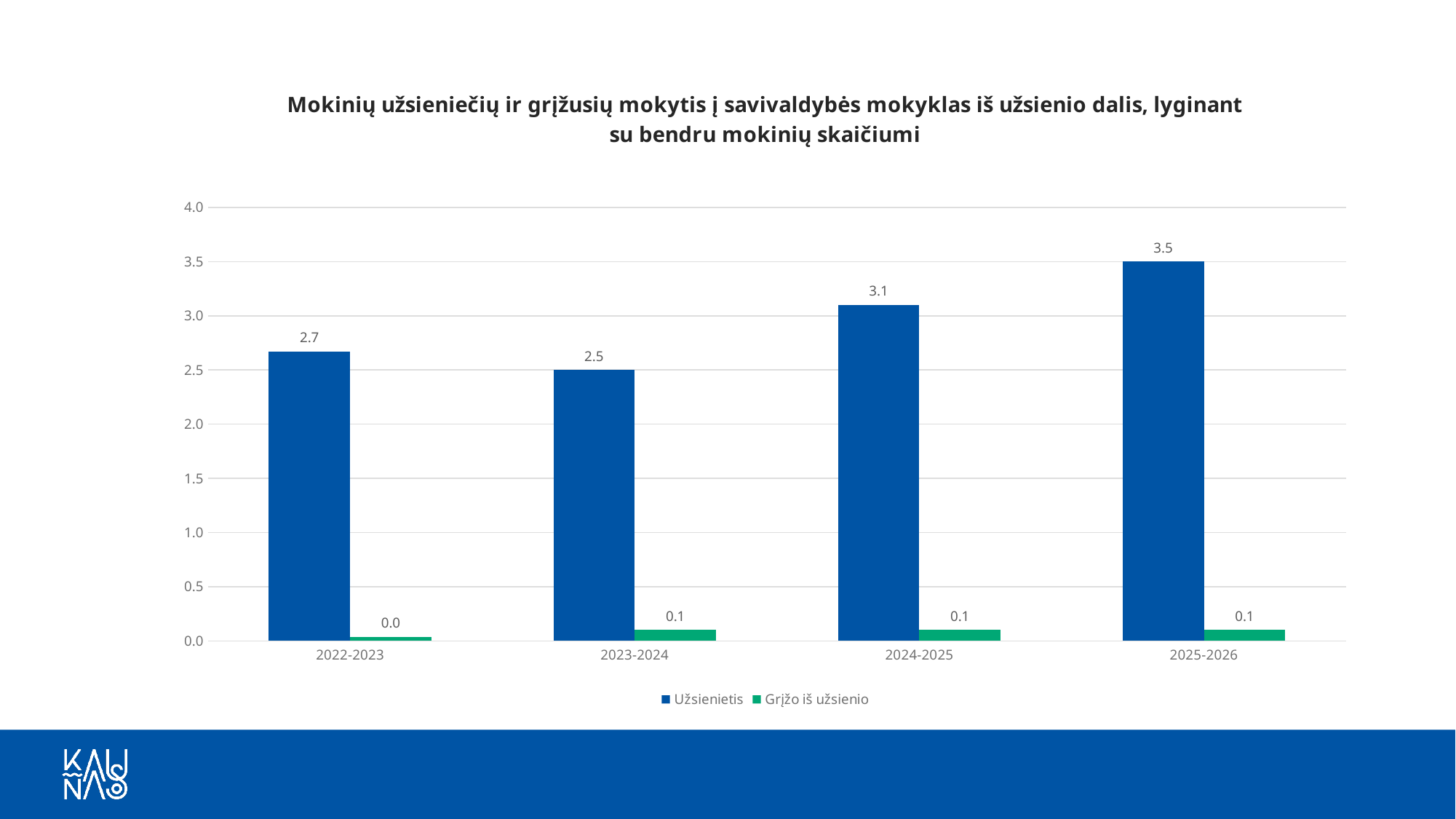
What kind of chart is shown on the slide? Bar chart How many series does the legend list? 2 What is the value for Užsienietis in 2025-2026? 3.5 Which is larger, the Užsienietis value for 2022-2023 or for 2024-2025? 2024-2025 What is the difference between the Užsienietis values for 2025-2026 and 2022-2023? 0.8 In which school year is the Užsienietis value lowest? 2023-2024 In which school year is the Grįžo iš užsienio value lowest? 2022-2023 What is the value for Grįžo iš užsienio in 2024-2025? 0.1 What is the value for Grįžo iš užsienio in 2022-2023? 0.0 What is the value for Užsienietis in 2023-2024? 2.5 How many school years are shown on the x axis? 4 In which school year is the Užsienietis value highest? 2025-2026